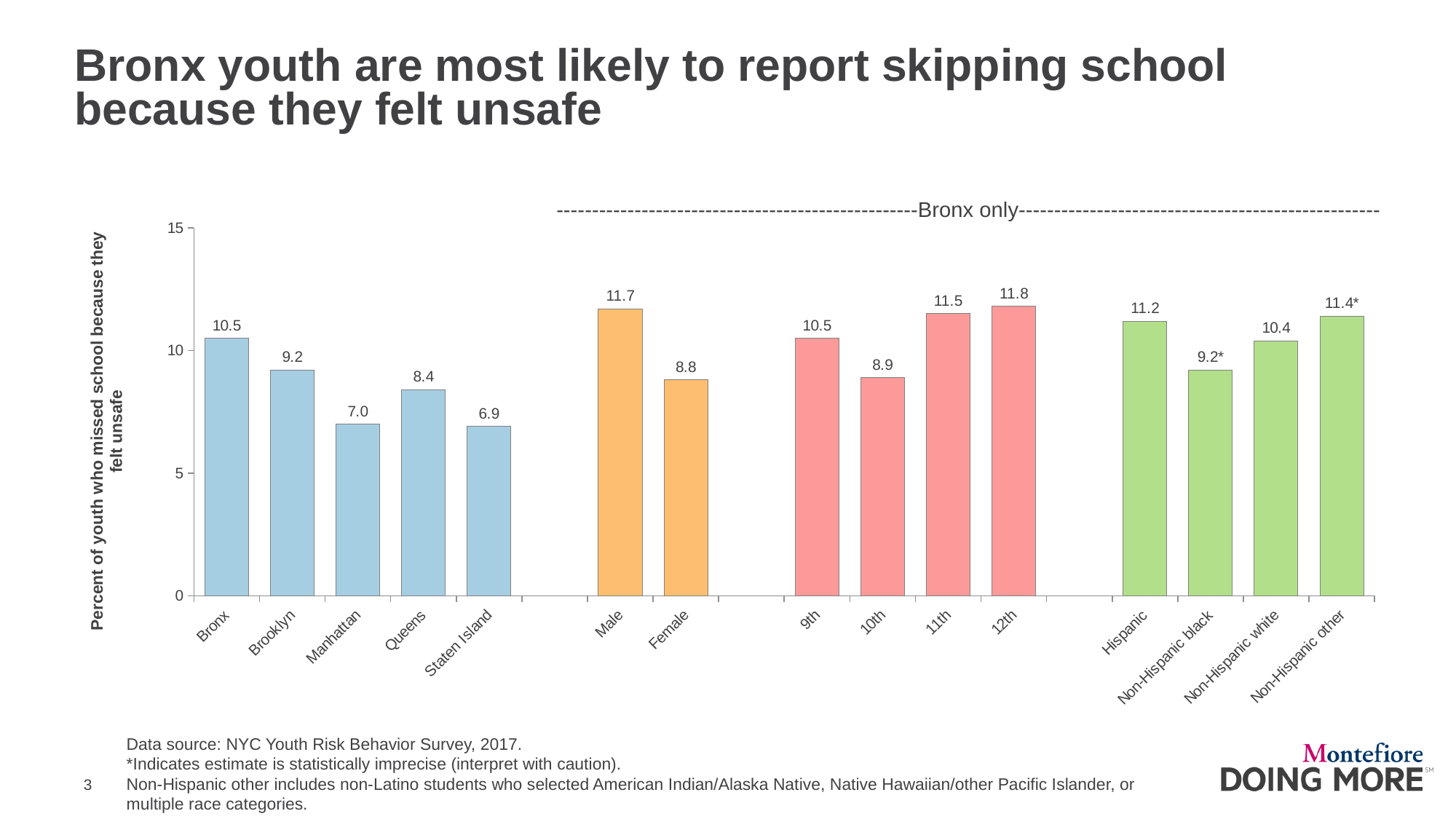
How many bars are plotted on the chart? 15 What is the y-axis label of the chart? Percent of youth who missed school because they felt unsafe What is the difference between the values for Male and Female? 2.9 What is the value for Non-Hispanic white? 10.4 What kind of chart is shown on the slide? bar chart Which is larger, the value for Brooklyn or the value for Queens? Brooklyn What is the value for Staten Island? 6.9 Which borough has the highest value? Bronx What is the value for Female? 8.8 Is the value for Manhattan greater or less than 10? less Which grade has the lowest value? 10th What is the value for Bronx? 10.5